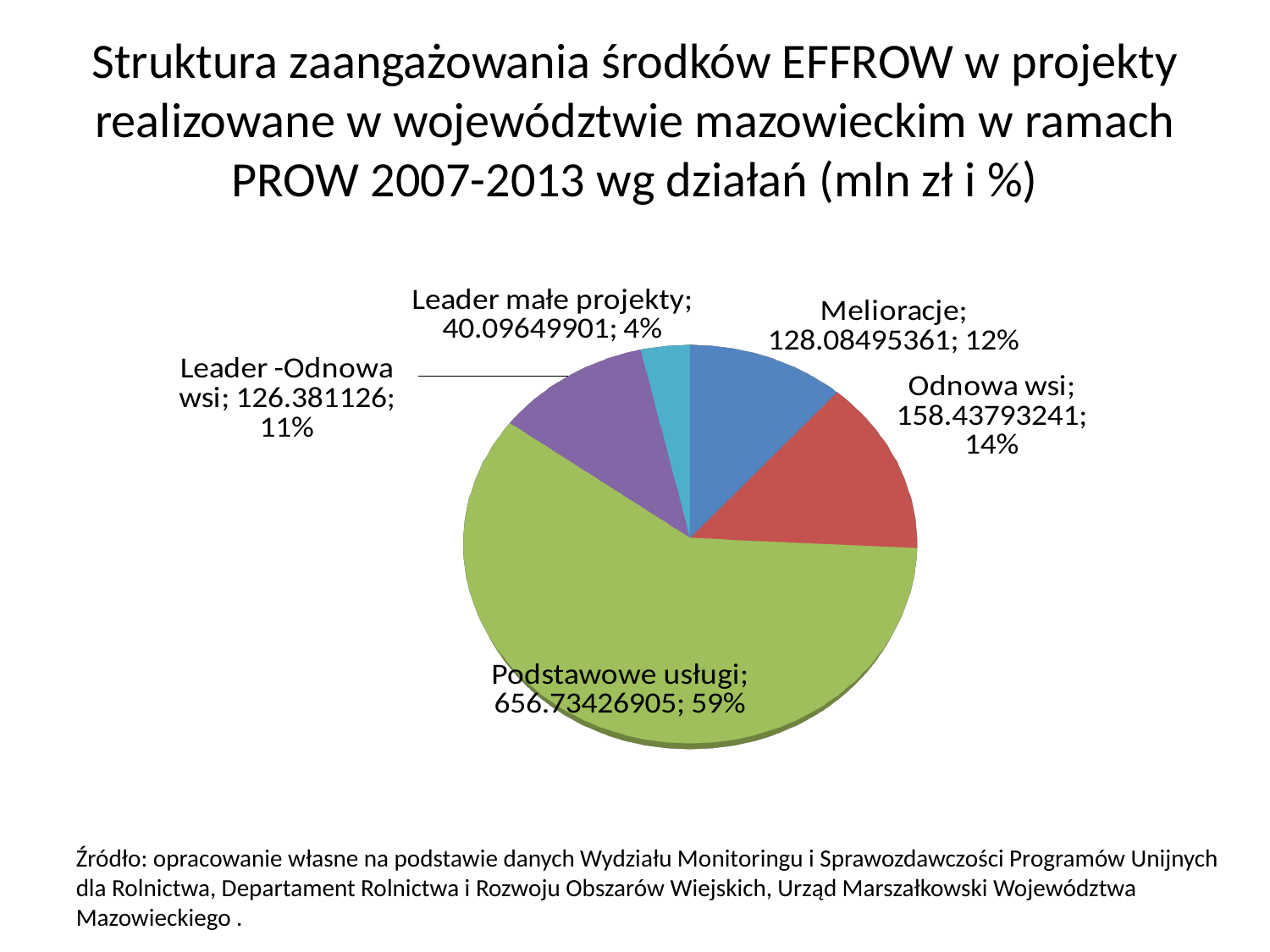
What is the difference in percentage share between Odnowa wsi and Melioracje? 2% How many slices does the pie chart have? 5 What percentage share does Melioracje have in the pie chart? 12% What value is shown for Podstawowe usługi? 656.73426905 What is the difference between the values for Podstawowe usługi and Leader małe projekty? 616.63777004 What type of chart is shown on the slide? pie chart Which is larger, the value for Odnowa wsi or the value for Melioracje? Odnowa wsi What percentage share does Leader -Odnowa wsi have? 11% Which category has the smallest slice of the pie? Leader małe projekty Which category has the largest slice of the pie? Podstawowe usługi What colour is the Podstawowe usługi slice? green What value is shown for Leader małe projekty? 40.09649901